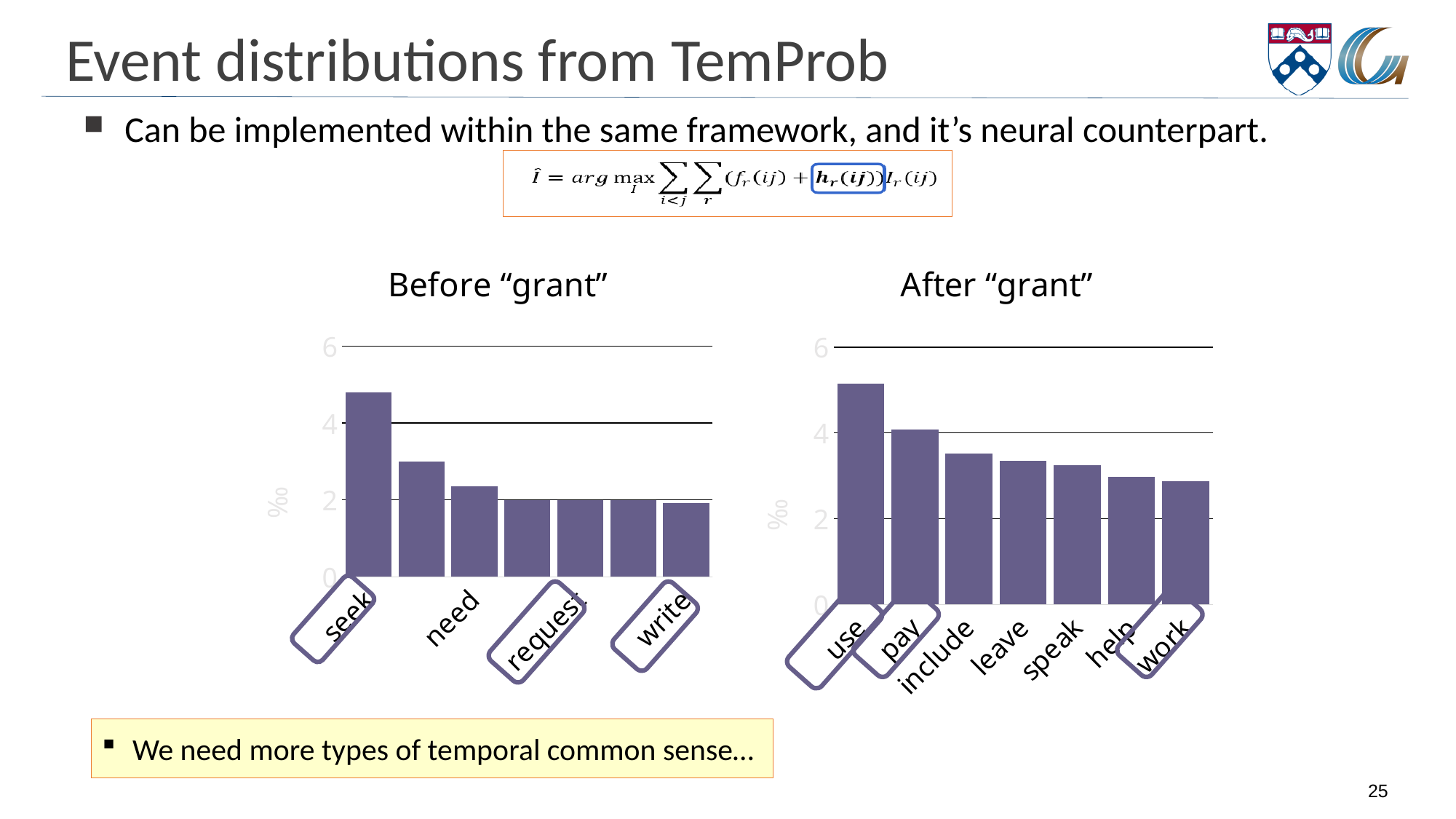
What kind of chart is the "Before "grant"" chart? bar chart In the "Before "grant"" chart, is the value for seek greater or less than 4? greater In the "Before "grant"" chart, which is larger, the value for seek or the value for need? seek In the "After "grant"" chart, which category has the highest value? use In the "Before "grant"" chart, which category has the highest value? seek In the "After "grant"" chart, is the value for include greater or less than 2? greater What is the title of the chart on the right side of the slide? After "grant" In the "After "grant"" chart, which is larger, the value for pay or the value for help? pay In the "After "grant"" chart, is the value for work greater or less than 4? less In the "After "grant"" chart, do the values rise or fall from left to right? fall How many categories are shown in the "After "grant"" chart? 7